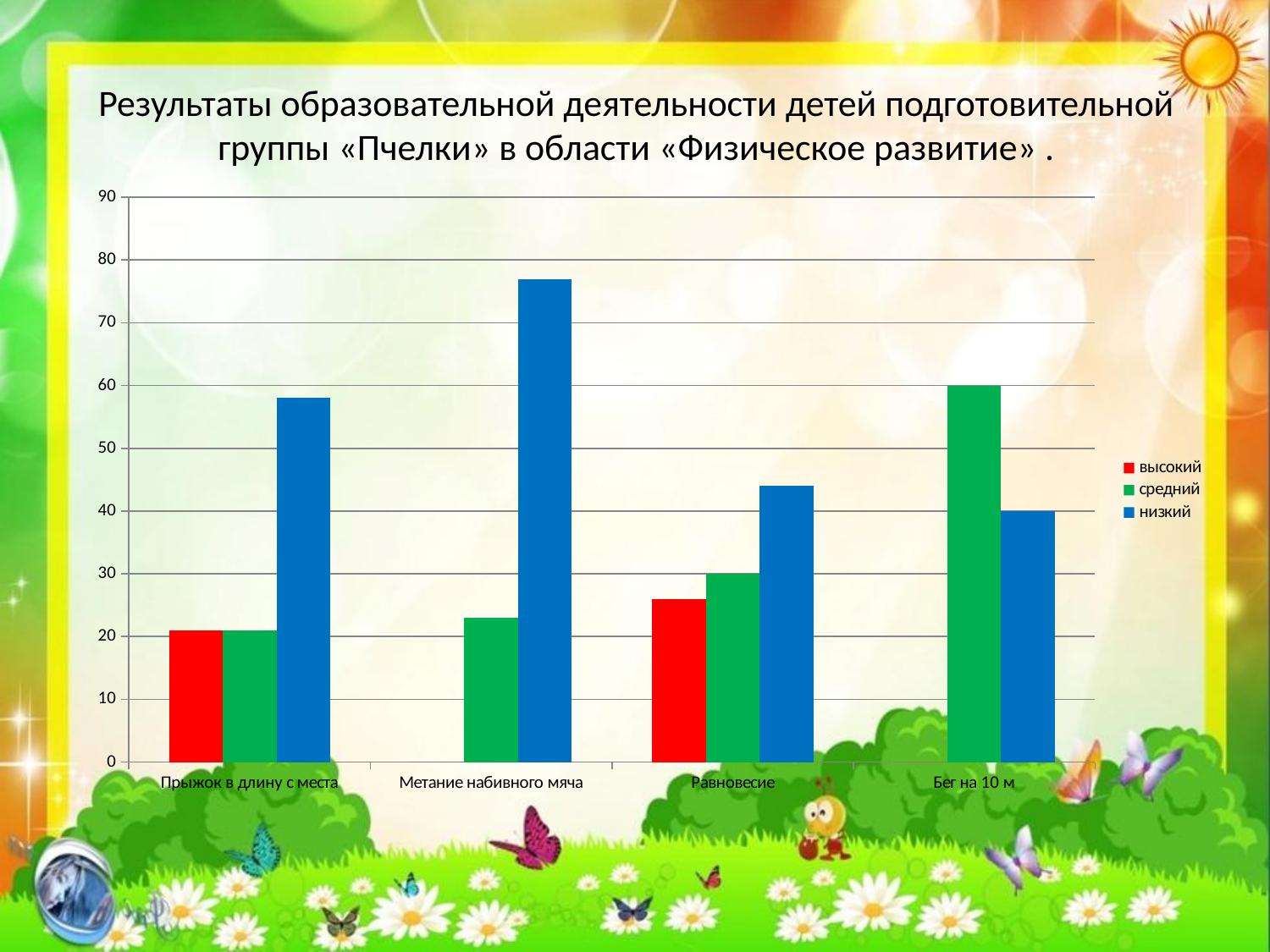
What is the value of the низкий series for Бег на 10 м? 40 Which series is shown in red in the legend? высокий What kind of chart is shown on the slide? bar chart Is the высокий value for Равновесие greater or less than 30? less Which category has the lowest низкий value? Бег на 10 м How many series does the legend list? 3 Is the низкий value for Прыжок в длину с места greater or less than 50? greater Is the низкий value for Метание набивного мяча greater or less than 70? greater What is the value of the средний series for Бег на 10 м? 60 For Равновесие, which is larger: the средний value or the низкий value? низкий Which category has the highest низкий value? Метание набивного мяча How many categories are shown on the x axis? 4